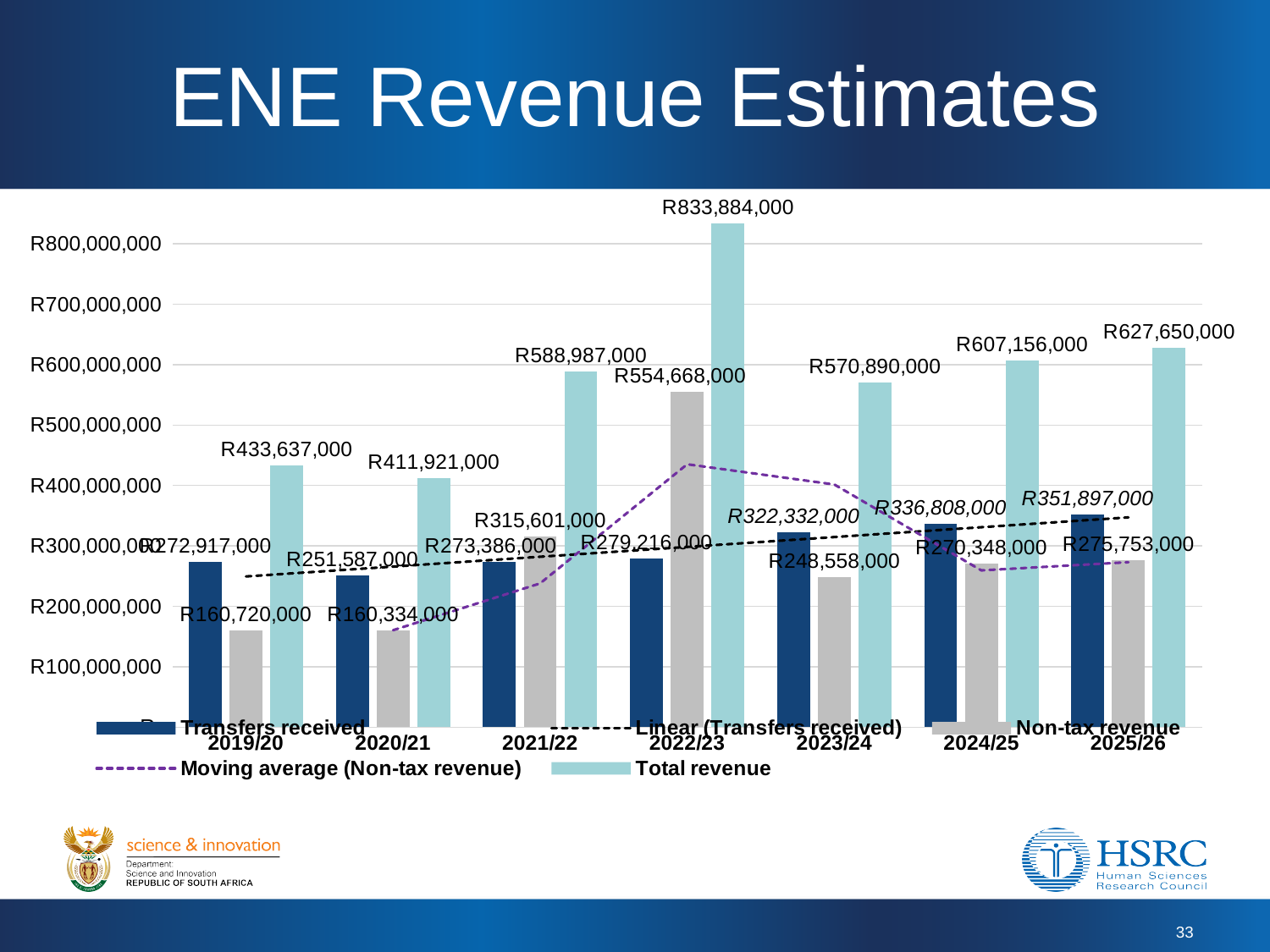
How many entries does the legend list? 5 Is the Non-tax revenue value for 2022/23 greater or less than R500,000,000? greater How many financial years are shown on the x axis? 7 Which is larger, Total revenue in 2023/24 or in 2024/25? 2024/25 What is the Total revenue value for 2022/23? R833,884,000 What is the Non-tax revenue value for 2021/22? R315,601,000 What is the difference between Total revenue in 2022/23 and 2021/22? R244,897,000 Which year has the lowest Total revenue? 2020/21 Do the Transfers received values rise or fall from 2020/21 to 2025/26? rise Which year has the highest Total revenue? 2022/23 What kind of chart is shown on the slide? bar chart What is the Transfers received value for 2025/26? R351,897,000